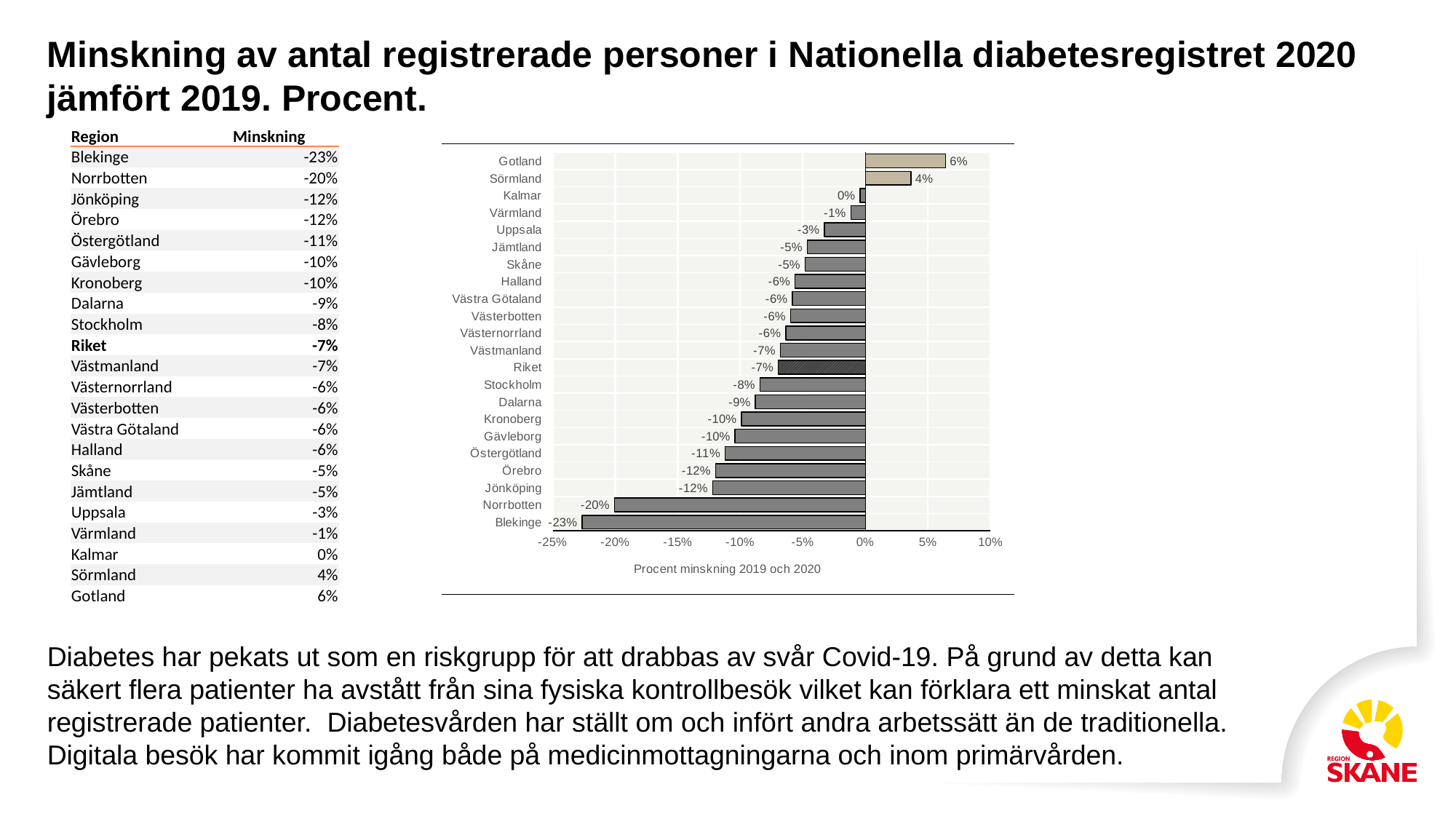
What value is shown for Skåne in the bar chart? -5% What value is shown for Gotland in the bar chart? 6% Which region has the highest value in the bar chart? Gotland What value is shown for Riket in the bar chart? -7% What is the difference in percentage points between the values for Norrbotten and Blekinge? 3 percentage points Which has the larger value, Stockholm or Dalarna? Stockholm What kind of chart is shown on the slide? Bar chart What value is shown for Blekinge in the bar chart? -23% How many bars are plotted in the chart? 22 What is the label shown below the x axis of the chart? Procent minskning 2019 och 2020 Which region has the lowest value in the bar chart? Blekinge What is the difference in percentage points between the values for Gotland and Sörmland? 2 percentage points